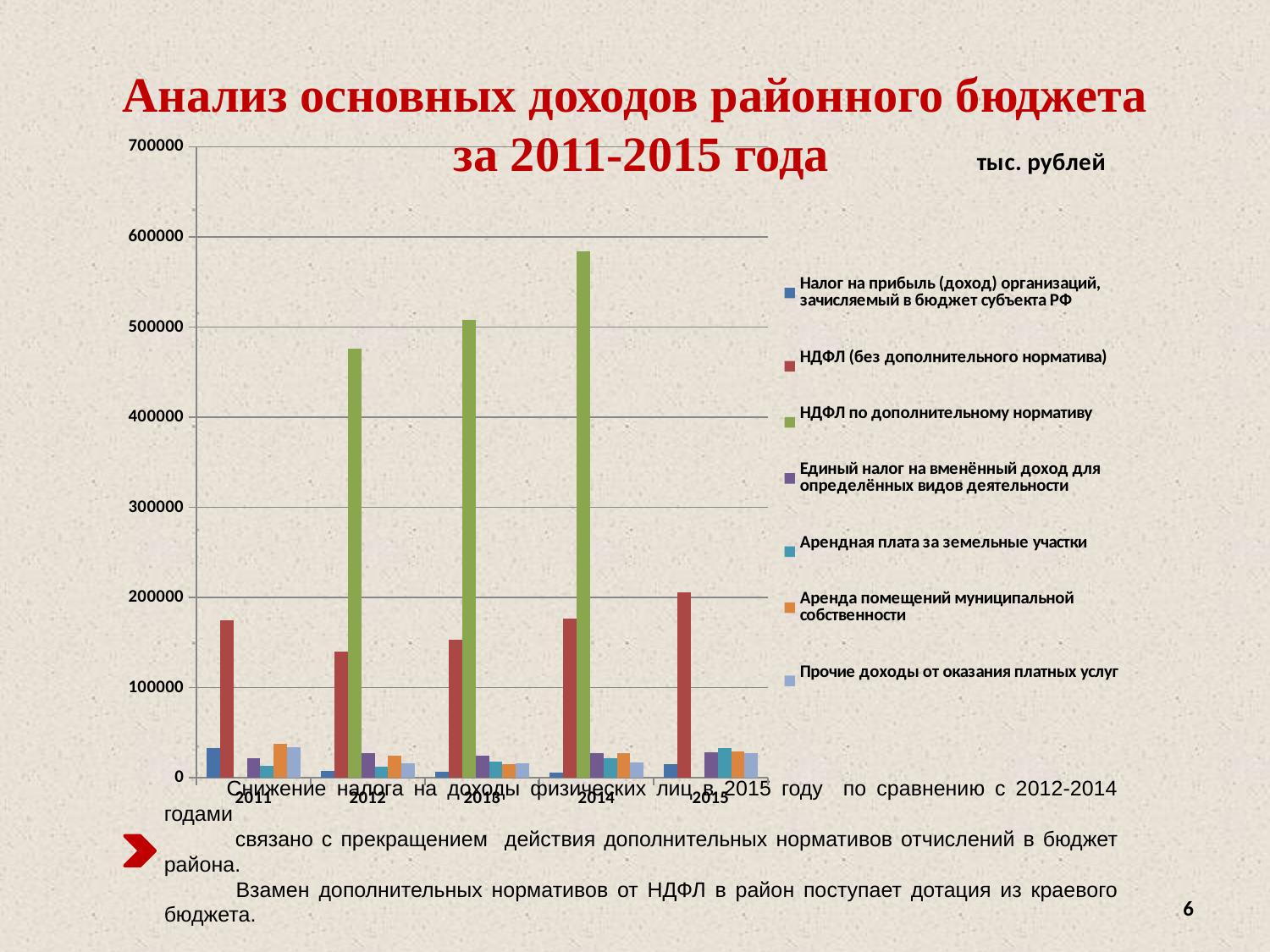
Is the value for НДФЛ по дополнительному нормативу in 2014 greater or less than 500000? greater Which is larger: НДФЛ по дополнительному нормативу in 2012 or in 2014? 2014 Does the value for НДФЛ по дополнительному нормативу rise or fall from 2012 to 2014? rise How many years are shown on the x axis of the chart? 5 How many series does the chart legend list? 7 What unit of measurement is indicated next to the chart? тыс. рублей In which year is the bar for НДФЛ по дополнительному нормативу the highest? 2014 What kind of chart is shown on the slide? bar chart Which series has the tallest bar in the whole chart? НДФЛ по дополнительному нормативу Is the value for НДФЛ (без дополнительного норматива) in 2012 greater or less than 100000? greater Is the value for НДФЛ (без дополнительного норматива) in 2011 greater or less than 200000? less